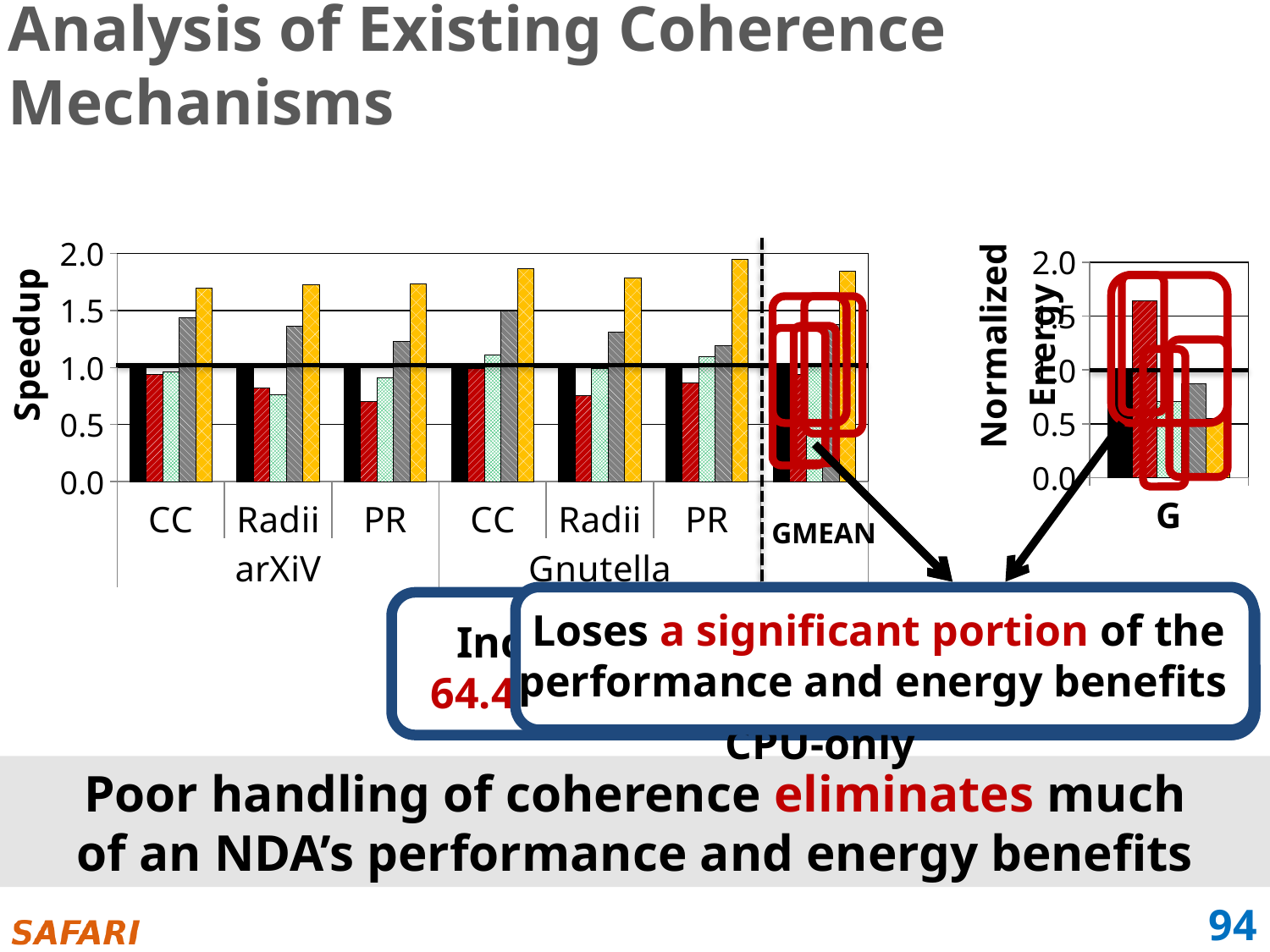
In the right chart, what is the label on the vertical axis? Normalized Energy In the left Speedup chart, how many bars are plotted in each benchmark group? 5 In the right Normalized Energy chart, is the red hatched bar greater or less than 1.5? greater In the left Speedup chart, is the red hatched bar for PR under arXiV greater or less than 1.0? less In the left Speedup chart, for Radii under arXiV, which is larger: the red hatched bar or the gray bar? the gray bar In the left Speedup chart, which bar is the highest in the CC group under arXiV? the yellow bar In the left Speedup chart, what is the label on the vertical axis? Speedup In the left Speedup chart, is the yellow bar for CC under arXiV greater or less than 1.5? greater In the left Speedup chart, how many benchmark groups (including GMEAN) are shown along the x axis? 7 What kind of chart is the left chart with the Speedup axis? bar chart